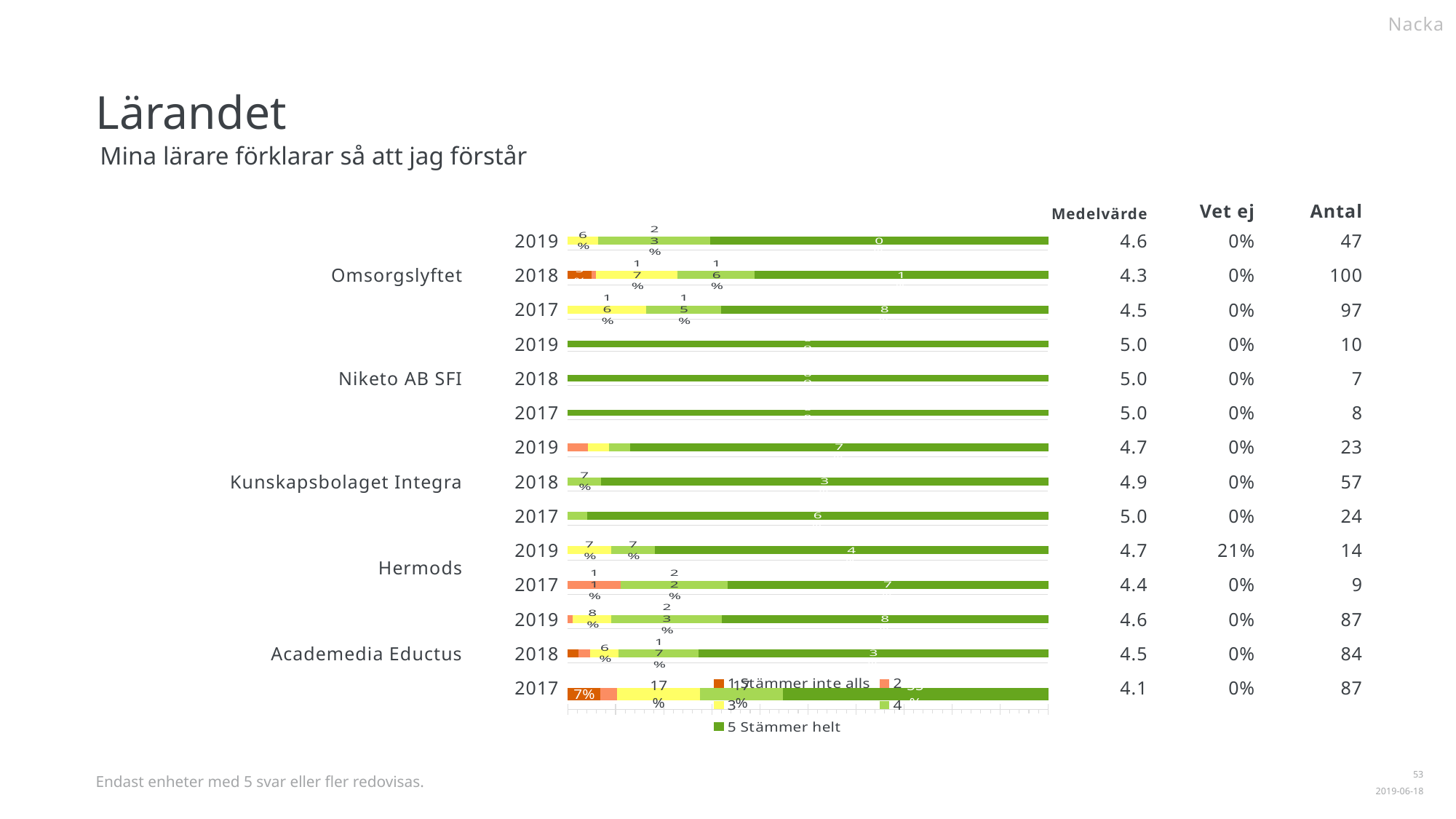
What is the first entry in the chart legend? 1 Stämmer inte alls What is the Vet ej value shown for Hermods 2019? 21% What is the Antal shown for Omsorgslyftet 2018? 100 Which unit and year has the lowest Medelvärde? Academedia Eductus 2017 What is the difference in Antal between Omsorgslyftet 2018 and Omsorgslyftet 2019? 53 What is the last entry in the chart legend? 5 Stämmer helt Which bar has a larger '5 Stämmer helt' share: Niketo AB SFI 2019 or Academedia Eductus 2017? Niketo AB SFI 2019 How many series does the chart legend list? 5 What kind of chart is shown on the slide? Stacked bar chart What is the data label for the '1 Stämmer inte alls' segment of the Academedia Eductus 2017 bar? 7% What is the Medelvärde shown for Hermods 2019? 4.7 How many bars (unit-year rows) are plotted in the chart? 14